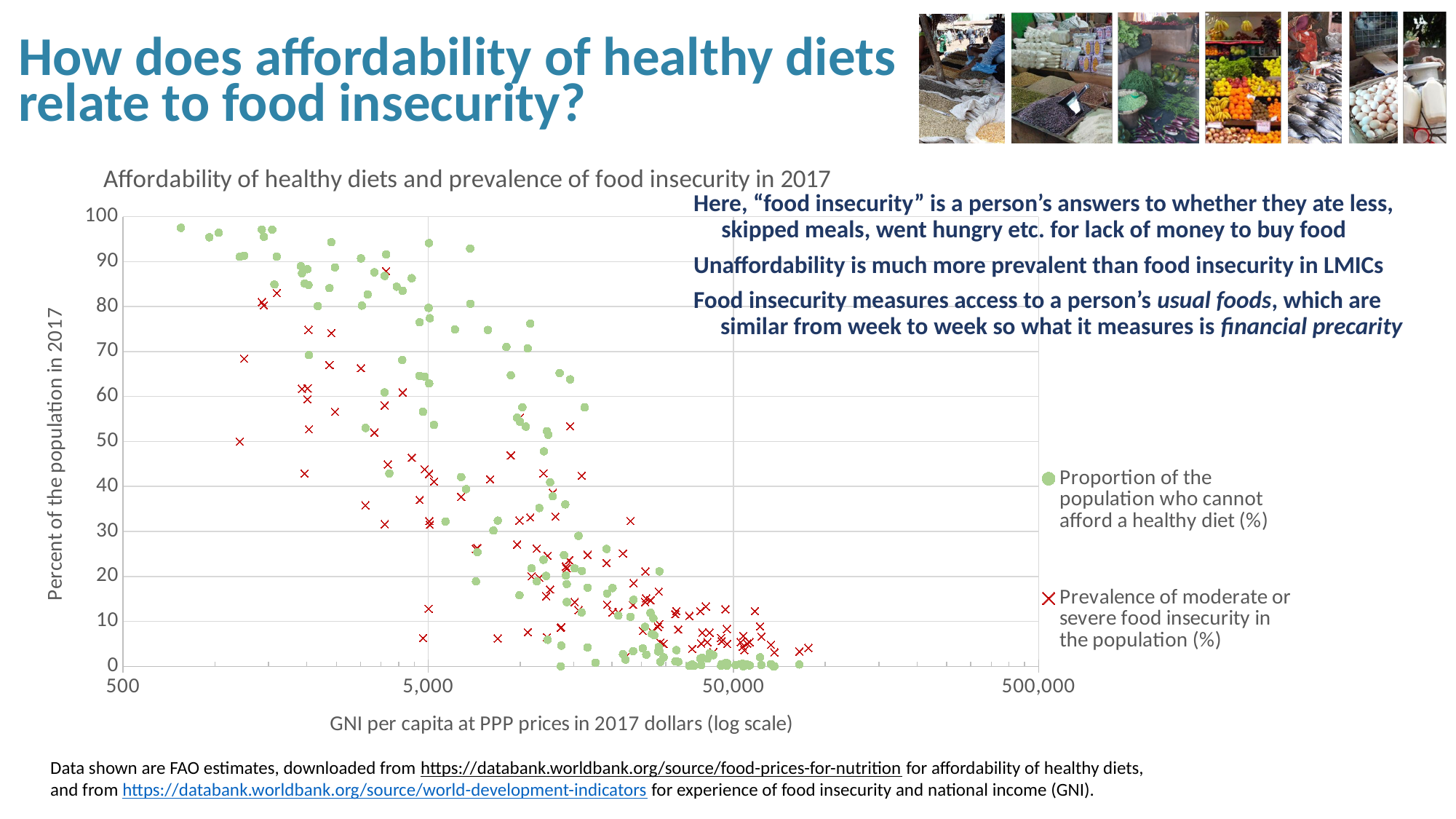
What is the lowest tick value shown on the chart's x axis? 500 Which series is plotted with red cross markers? Prevalence of moderate or severe food insecurity in the population (%) Which series is plotted with green circle markers? Proportion of the population who cannot afford a healthy diet (%) What kind of chart is shown on the slide? scatter chart As GNI per capita increases along the x axis, do the values for the prevalence of moderate or severe food insecurity generally rise or fall? fall As GNI per capita increases along the x axis, do the values for the proportion of the population who cannot afford a healthy diet generally rise or fall? fall How many series does the chart's legend list? 2